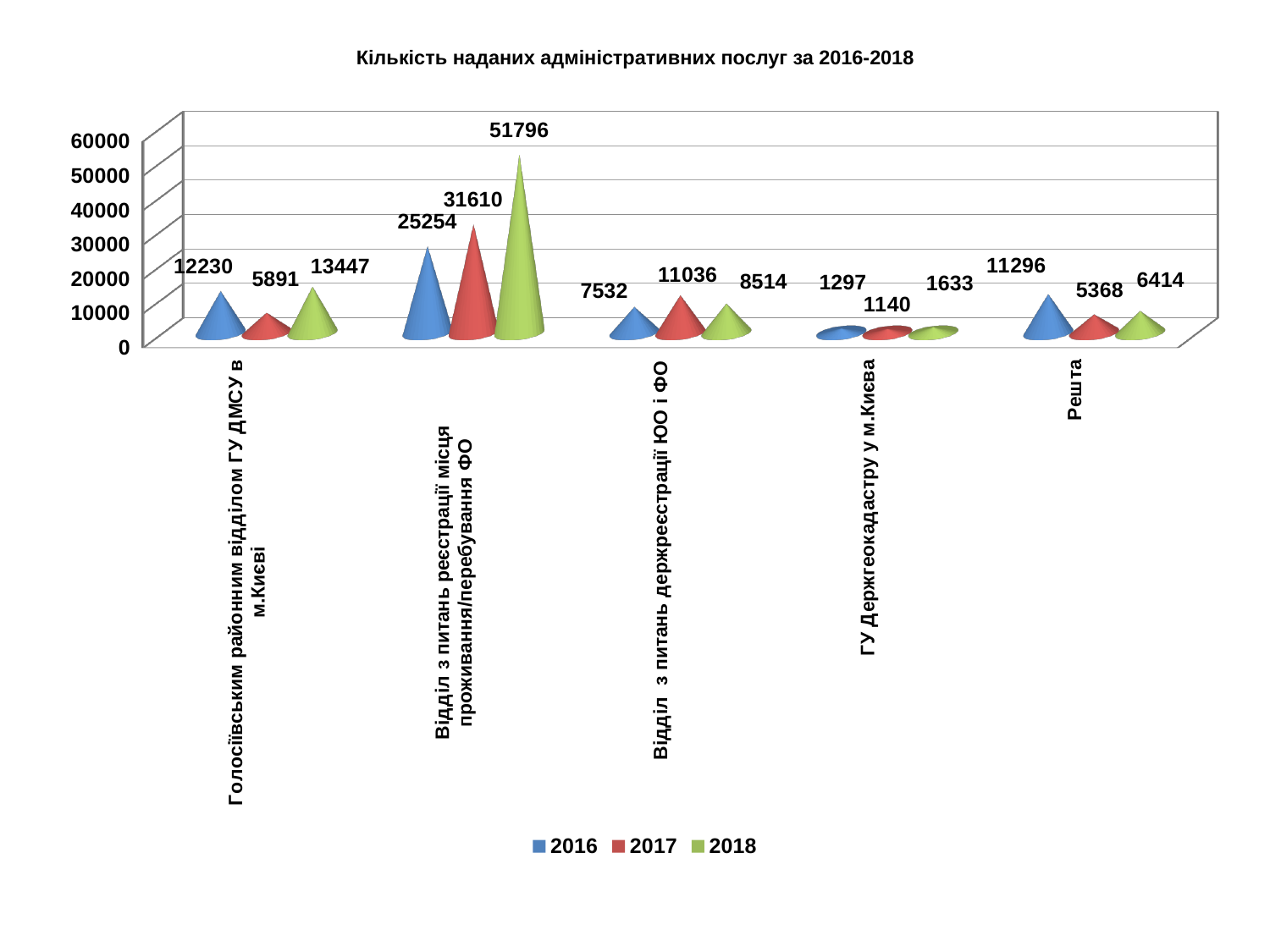
What is the value for 2017 for "ГУ Держгеокадастру у м.Києва"? 1140 Which category has the highest value for 2017? Відділ з питань реєстрації місця проживання/перебування ФО Which category has the lowest value for 2016? ГУ Держгеокадастру у м.Києва Which is larger for "Голосіївським районним відділом ГУ ДМСУ в м.Києві": the 2016 value or the 2018 value? 2018 What kind of chart is shown? bar chart What is the value for 2016 for "Решта"? 11296 What is the difference between the 2018 and 2017 values for "Відділ з питань реєстрації місця проживання/перебування ФО"? 20186 How many series does the legend list? 3 Is the 2017 value for "Відділ з питань держреєстрації ЮО і ФО" greater or less than 10000? greater What is the title of the chart? Кількість наданих адміністративних послуг за 2016-2018 How many categories are shown on the x axis? 5 What is the value for 2018 for "Відділ з питань реєстрації місця проживання/перебування ФО"? 51796